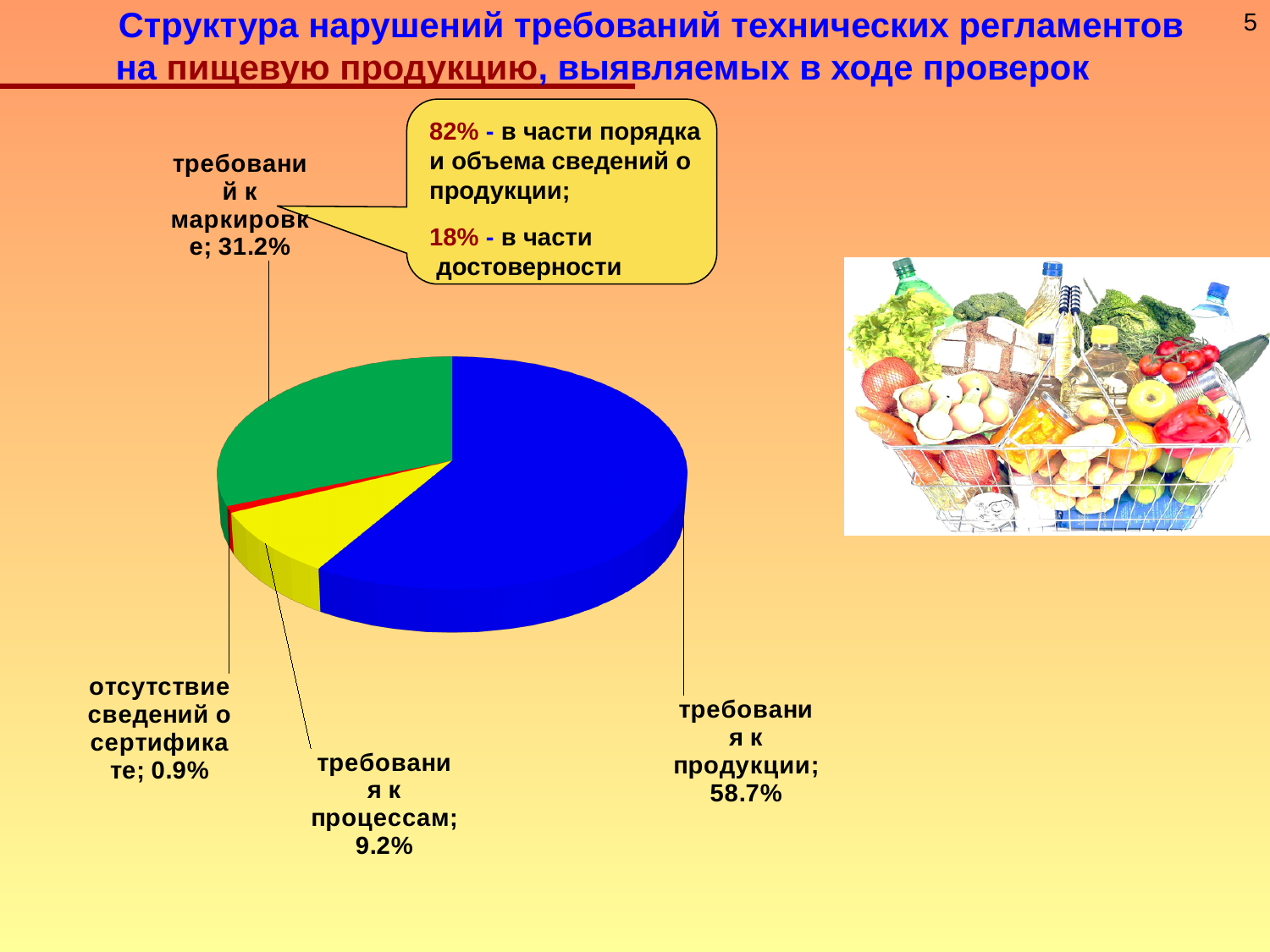
What share of violations is attributed to "требования к продукции"? 58.7% What share of violations is attributed to "требования к маркировке"? 31.2% According to the callout, what percentage of labeling violations concerns the order and volume of product information ("в части порядка и объема сведений о продукции")? 82% What share of violations is attributed to "требования к процессам"? 9.2% What kind of chart is shown on the slide? pie chart Which category has the largest share of the pie? требования к продукции Which category has the smallest share of the pie? отсутствие сведений о сертификате How many slices does the pie chart have? 4 What is the difference in percentage points between "требования к продукции" and "требования к маркировке"? 27.5 Which is larger: the share for "требования к процессам" or the share for "требования к маркировке"? требования к маркировке What share of violations is attributed to "отсутствие сведений о сертификате"? 0.9% What colour is the slice for "требования к продукции"? blue